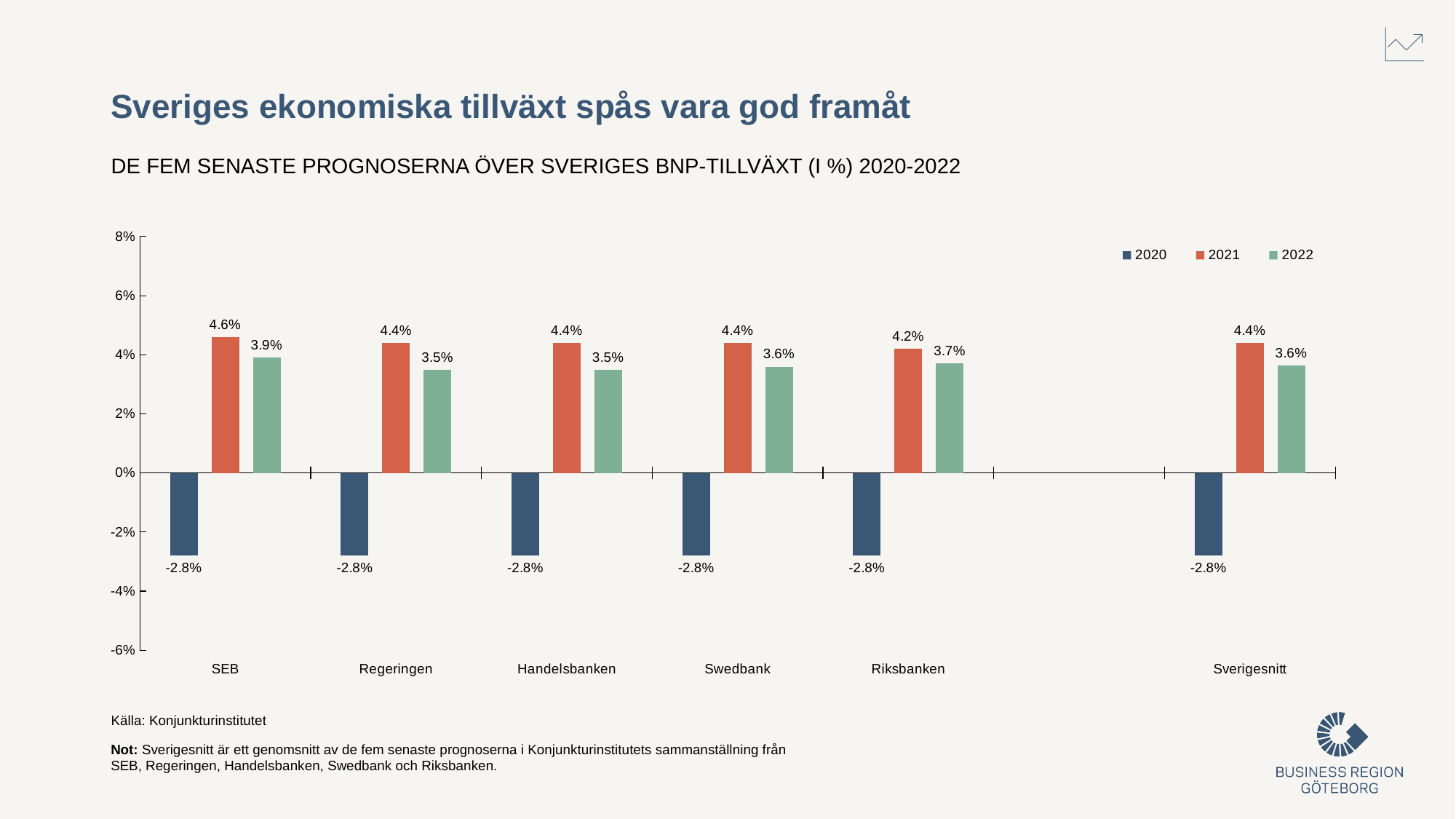
Which is larger, the 2022 value for Swedbank or the 2022 value for Riksbanken? Riksbanken Which category has the highest 2021 value? SEB What kind of chart is shown on the slide? Bar chart What is the 2022 forecast value for Riksbanken? 3.7% What is the 2021 forecast value for SEB? 4.6% Which category has the highest 2022 value? SEB What is the difference between the 2021 and 2022 values for Regeringen? 0.9% What is the 2020 value for Handelsbanken? -2.8% What is the 2022 value for Sverigesnitt? 3.6% Which category has the lowest 2021 value? Riksbanken How many series does the legend list? 3 How many categories are shown on the x axis? 6